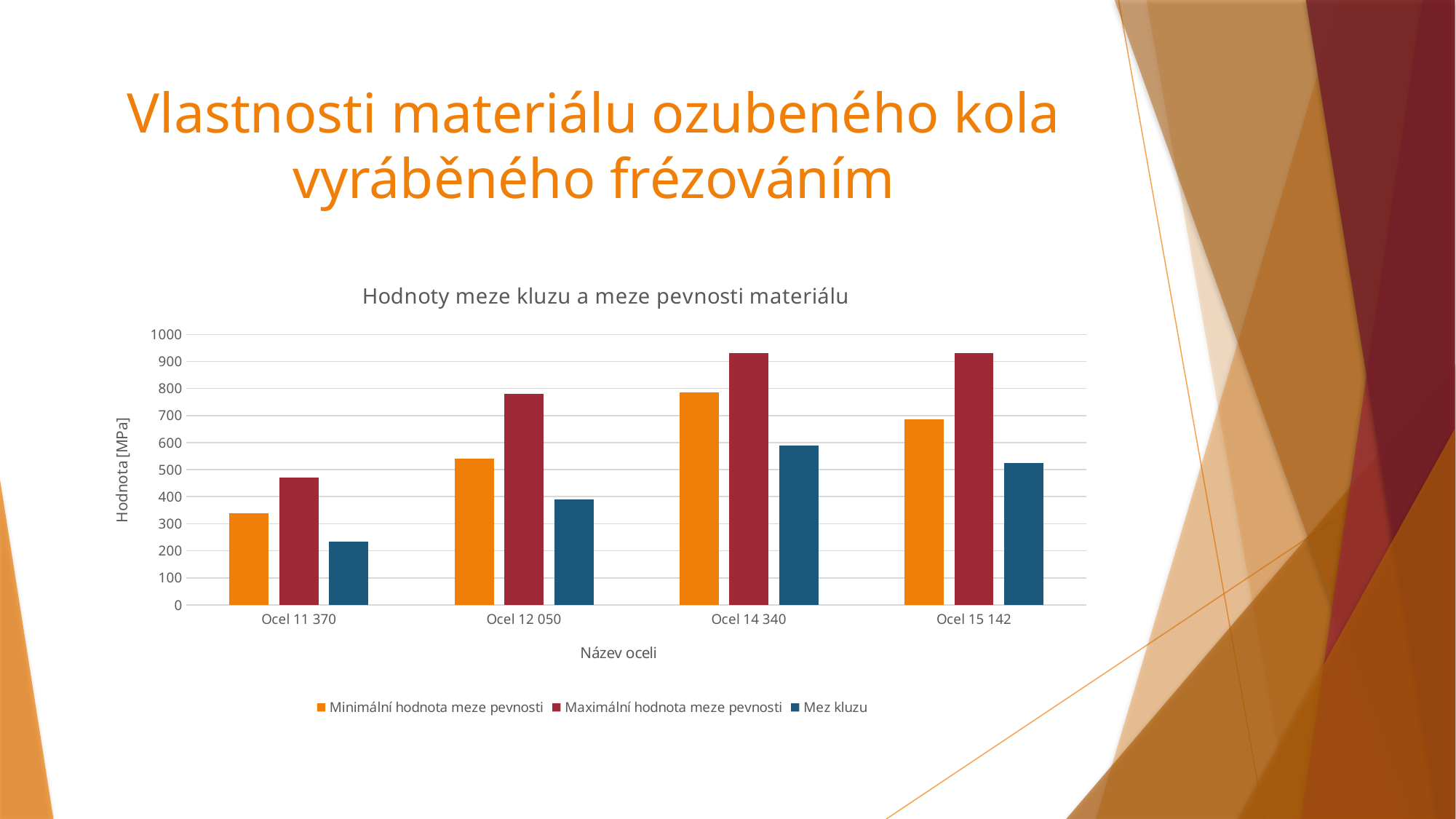
Which is larger: the Minimální hodnota meze pevnosti for Ocel 14 340 or for Ocel 15 142? Ocel 14 340 Which steel has the highest Minimální hodnota meze pevnosti? Ocel 14 340 What is the label of the vertical axis? Hodnota [MPa] What kind of chart is shown on the slide? bar chart Which steel has the lowest Mez kluzu? Ocel 11 370 Is the Maximální hodnota meze pevnosti for Ocel 12 050 greater or less than 800? less Is the Mez kluzu for Ocel 14 340 greater or less than 500? greater How many series does the legend list? 3 Which steel has the highest Mez kluzu? Ocel 14 340 Is the Minimální hodnota meze pevnosti for Ocel 11 370 greater or less than 300? greater What is the title of the chart? Hodnoty meze kluzu a meze pevnosti materiálu How many steel types (categories) are shown on the x axis? 4